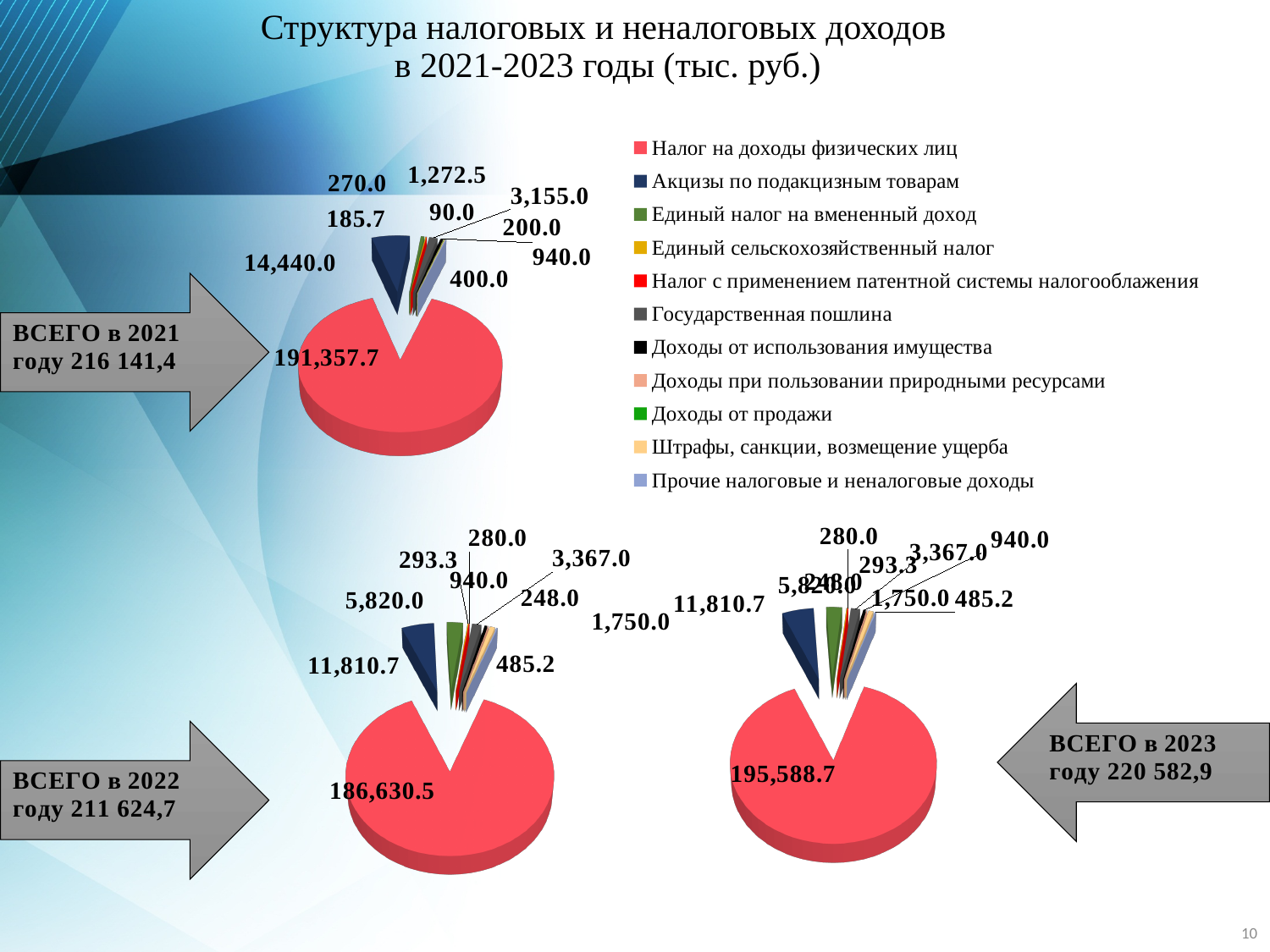
How many entries does the legend list? 11 What kind of charts are shown on the slide? Pie charts What is the difference between the Налог на доходы физических лиц value in the 2023 pie chart and in the 2022 pie chart? 8,958.2 What is the title of the slide's charts? Структура налоговых и неналоговых доходов в 2021-2023 годы (тыс. руб.) In the 2022 pie chart (bottom left), what is the value for Налог на доходы физических лиц? 186,630.5 In the 2021 pie chart (top), what is the value for Налог на доходы физических лиц? 191,357.7 How many pie charts are on the slide? 3 In the 2021 pie chart (top), what is the value for Акцизы по подакцизным товарам? 14,440.0 Is the value for Налог на доходы физических лиц larger in the 2023 pie chart or in the 2022 pie chart? 2023 In the 2022 pie chart (bottom left), what is the value for Акцизы по подакцизным товарам? 11,810.7 Which category has the largest slice in the 2022 pie chart (bottom left)? Налог на доходы физических лиц In the 2023 pie chart (bottom right), what is the value for Налог на доходы физических лиц? 195,588.7